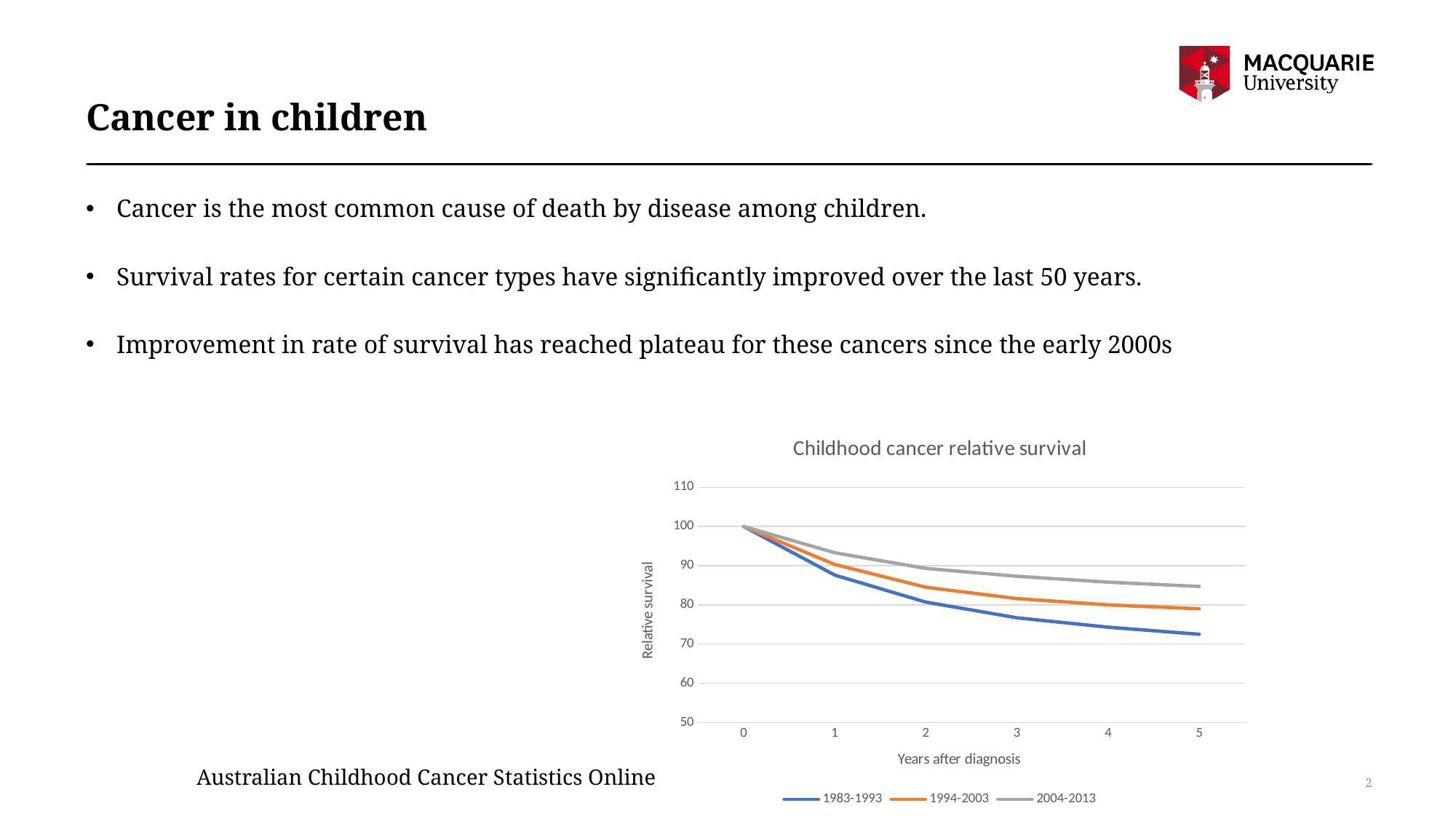
What is the title of the chart? Childhood cancer relative survival What kind of chart is shown on the slide? line chart How many series does the legend of the chart list? 3 Which series has the lowest relative survival at 5 years after diagnosis? 1983-1993 Is the relative survival for 1983-1993 at 5 years after diagnosis greater or less than 80? less Do the relative survival values rise or fall as years after diagnosis increase? fall At 3 years after diagnosis, which series has the larger relative survival, 1994-2003 or 1983-1993? 1994-2003 Is the relative survival for 2004-2013 at 1 year after diagnosis greater or less than 90? greater Is the relative survival for 2004-2013 at 5 years after diagnosis greater or less than 80? greater Which series has the highest relative survival at 5 years after diagnosis? 2004-2013 How many points along the x axis (years after diagnosis) are plotted for each series? 6 What is the relative survival value for the 1983-1993 series at 0 years after diagnosis? 100